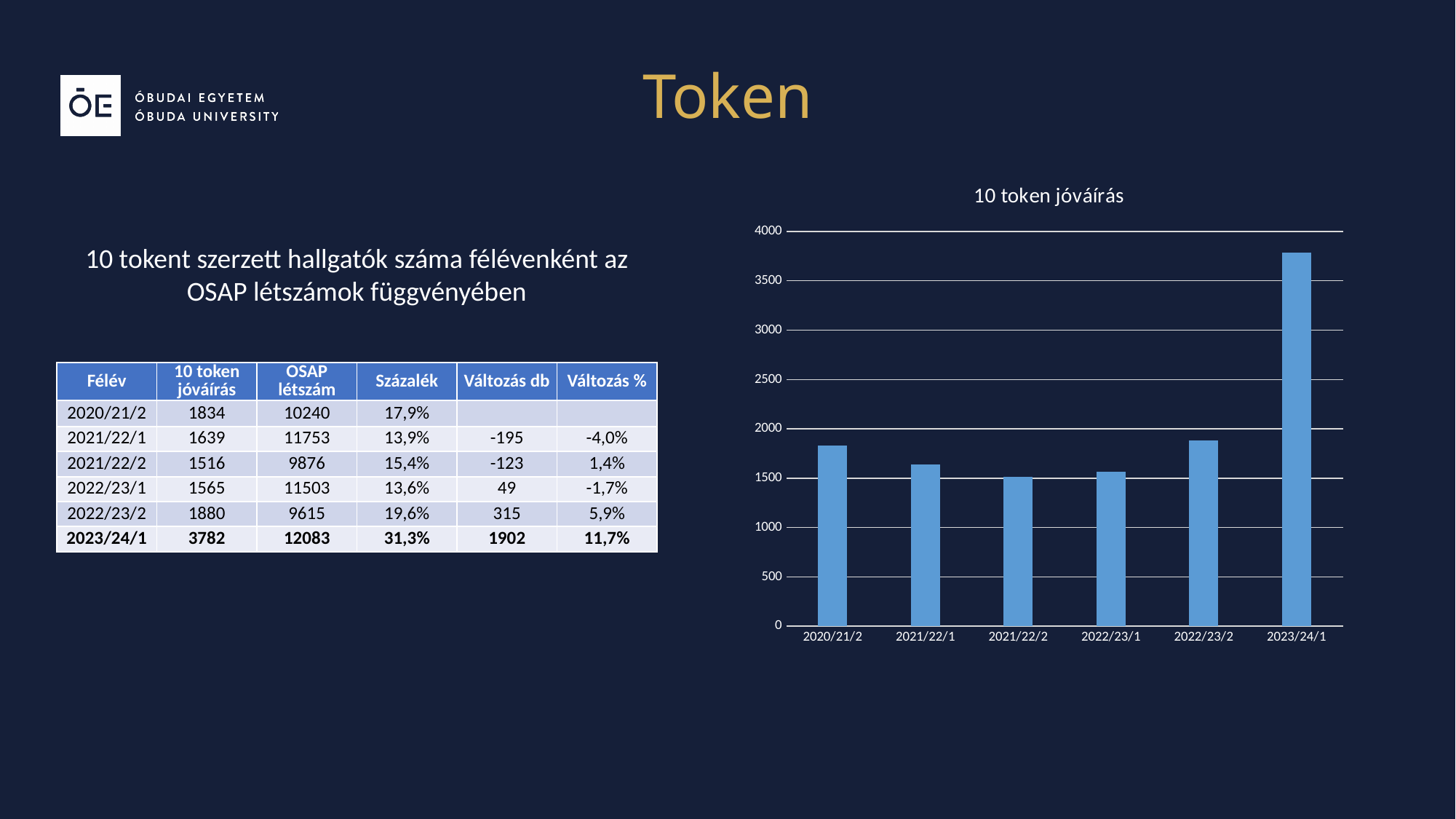
Which semester has the highest bar in the chart? 2023/24/1 What is the difference between the 10 token jóváírás values for 2023/24/1 and 2022/23/2? 1902 Is the value for 2020/21/2 greater or less than 2000? less What is the title of the chart? 10 token jóváírás What is the 10 token jóváírás value for 2023/24/1? 3782 How many semesters (bars) are shown in the chart? 6 Is the value for 2021/22/2 greater or less than 1000? greater Is the value for 2023/24/1 greater or less than 3500? greater Do the values rise or fall from 2022/23/1 to 2023/24/1? rise What is the 10 token jóváírás value for 2020/21/2? 1834 Which is larger in the chart, the value for 2022/23/2 or the value for 2021/22/1? 2022/23/2 What kind of chart is shown on the slide? bar chart